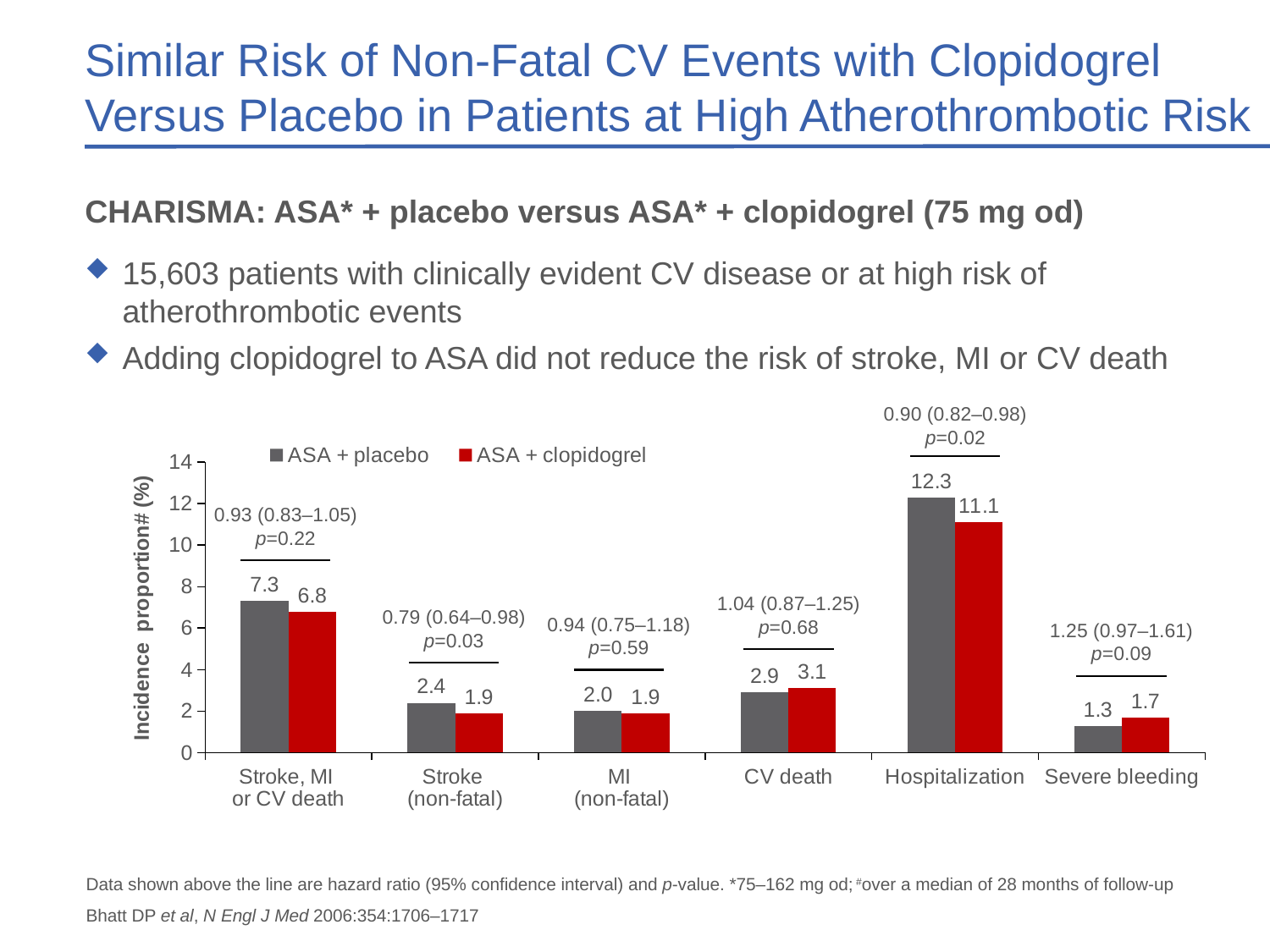
What is the incidence proportion for ASA + clopidogrel in the Stroke, MI or CV death category? 6.8 In the CV death category, which series has the larger value, ASA + placebo or ASA + clopidogrel? ASA + clopidogrel Which category has the lowest incidence proportion for ASA + placebo? Severe bleeding How many series does the chart legend list? 2 What is the incidence proportion for ASA + placebo in the Hospitalization category? 12.3 What is the difference between the ASA + placebo and ASA + clopidogrel values in the Stroke (non-fatal) category? 0.5 What is the incidence proportion for ASA + clopidogrel in the Severe bleeding category? 1.7 What is the difference between the ASA + placebo and ASA + clopidogrel values in the Hospitalization category? 1.2 Is the ASA + clopidogrel value for Hospitalization greater or less than 10? greater How many categories are shown on the x axis of the chart? 6 Which category has the highest incidence proportion for ASA + placebo? Hospitalization What kind of chart is shown on the slide? Bar chart